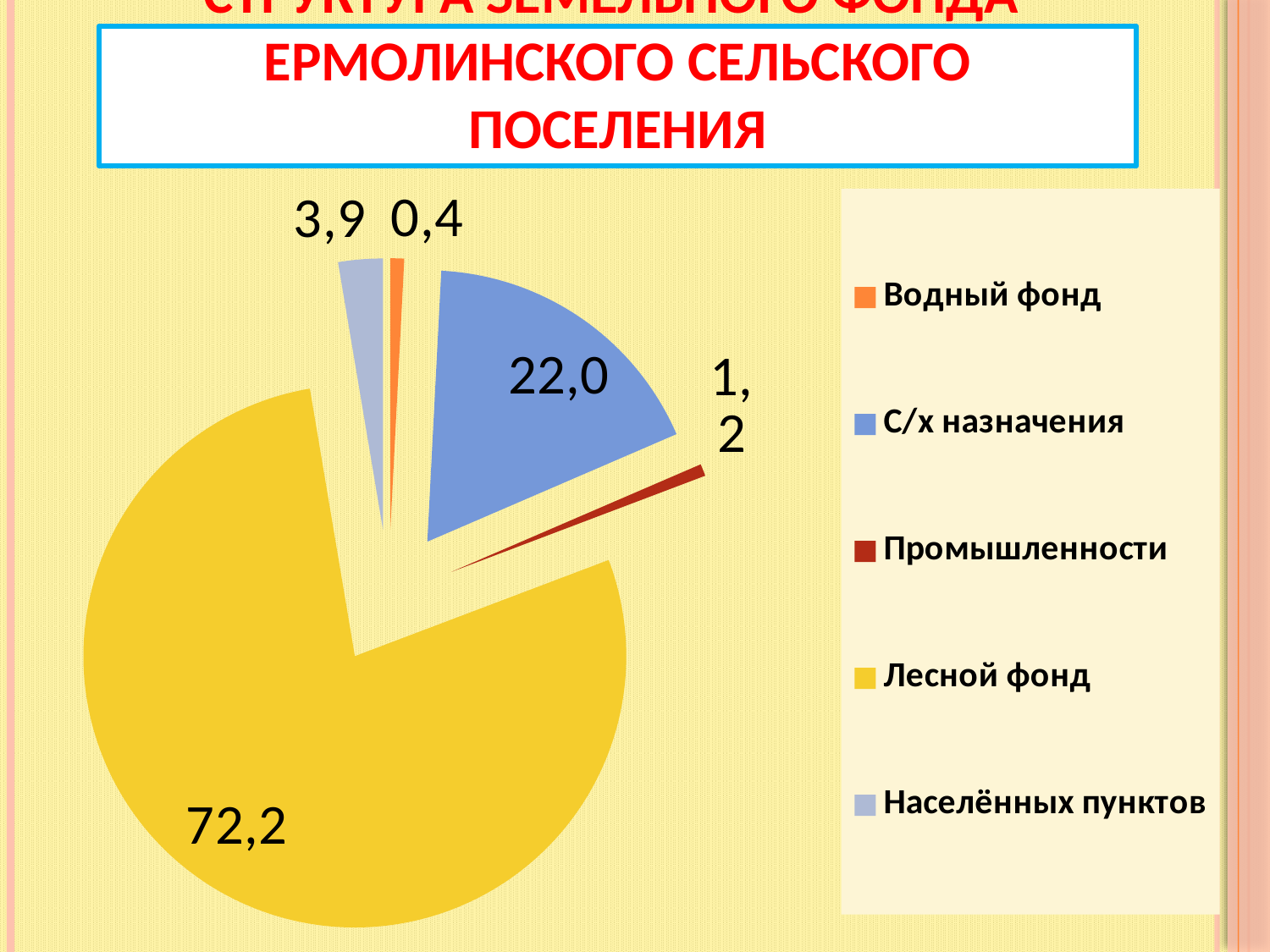
What is the value for Населённых пунктов? 3,9 What colour is the slice for Промышленности? dark red Which category has the largest slice of the pie? Лесной фонд Which is larger, the value for Населённых пунктов or the value for Промышленности? Населённых пунктов What is the value for Промышленности? 1,2 What is the value for С/х назначения? 22,0 What is the value for Водный фонд? 0,4 What kind of chart is shown on the slide? pie chart How many categories does the legend list? 5 Which category has the smallest slice of the pie? Водный фонд What is the difference between the values for Лесной фонд and С/х назначения? 50,2 What is the value for Лесной фонд? 72,2